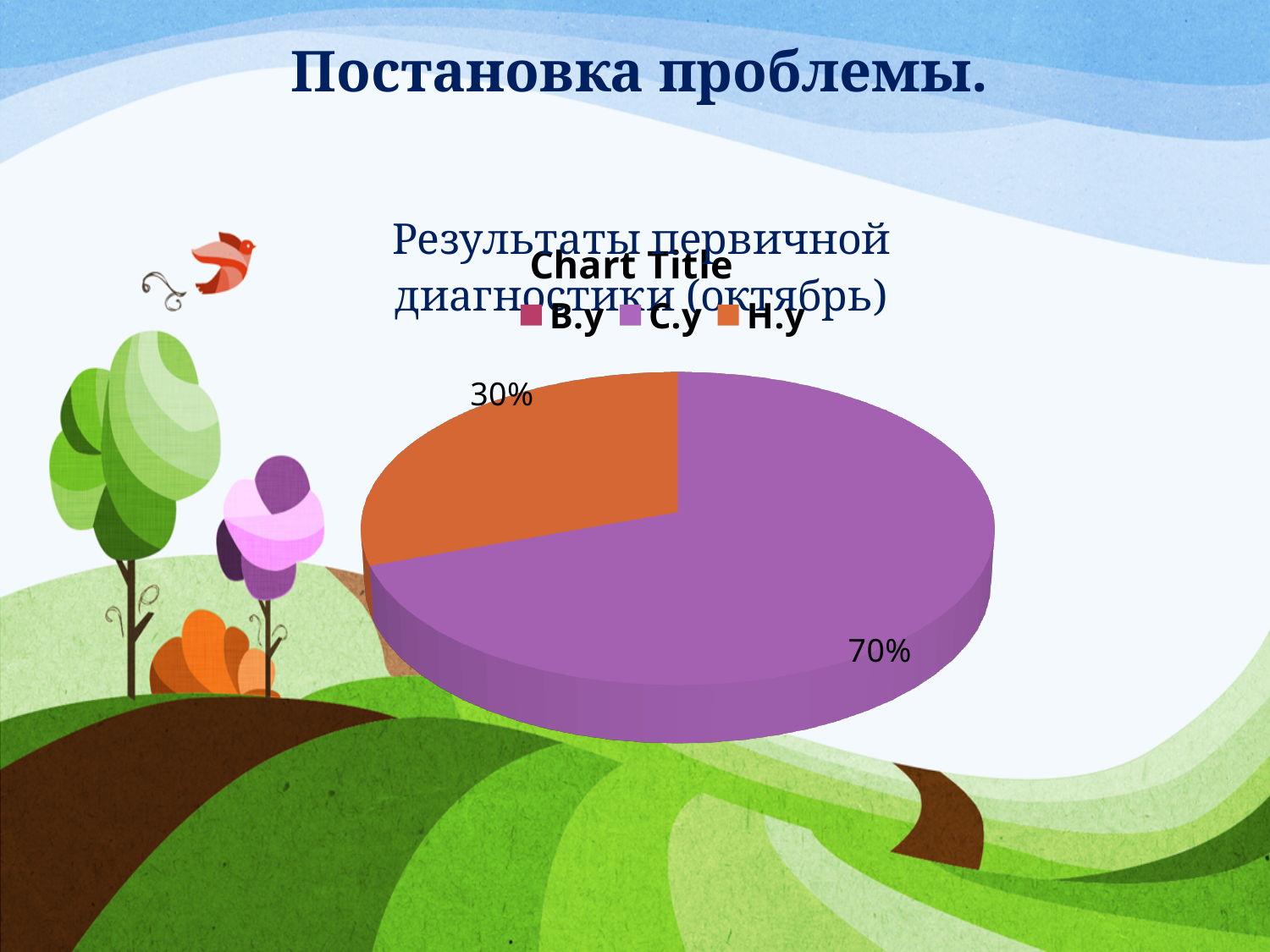
What is the difference in percentage points between the С.у slice and the Н.у slice? 40 What is the title shown on the chart itself? Chart Title Is the share for Н.у greater or less than 50%? less What kind of chart is shown on the slide? pie chart How many slices are visible in the pie? 2 Which category has the largest slice of the pie? С.у How many entries does the chart legend list? 3 What share of the pie does С.у have? 70% Which of the two visible slices is larger, С.у or Н.у? С.у What share of the pie does Н.у have? 30% What colour is the slice for С.у? purple